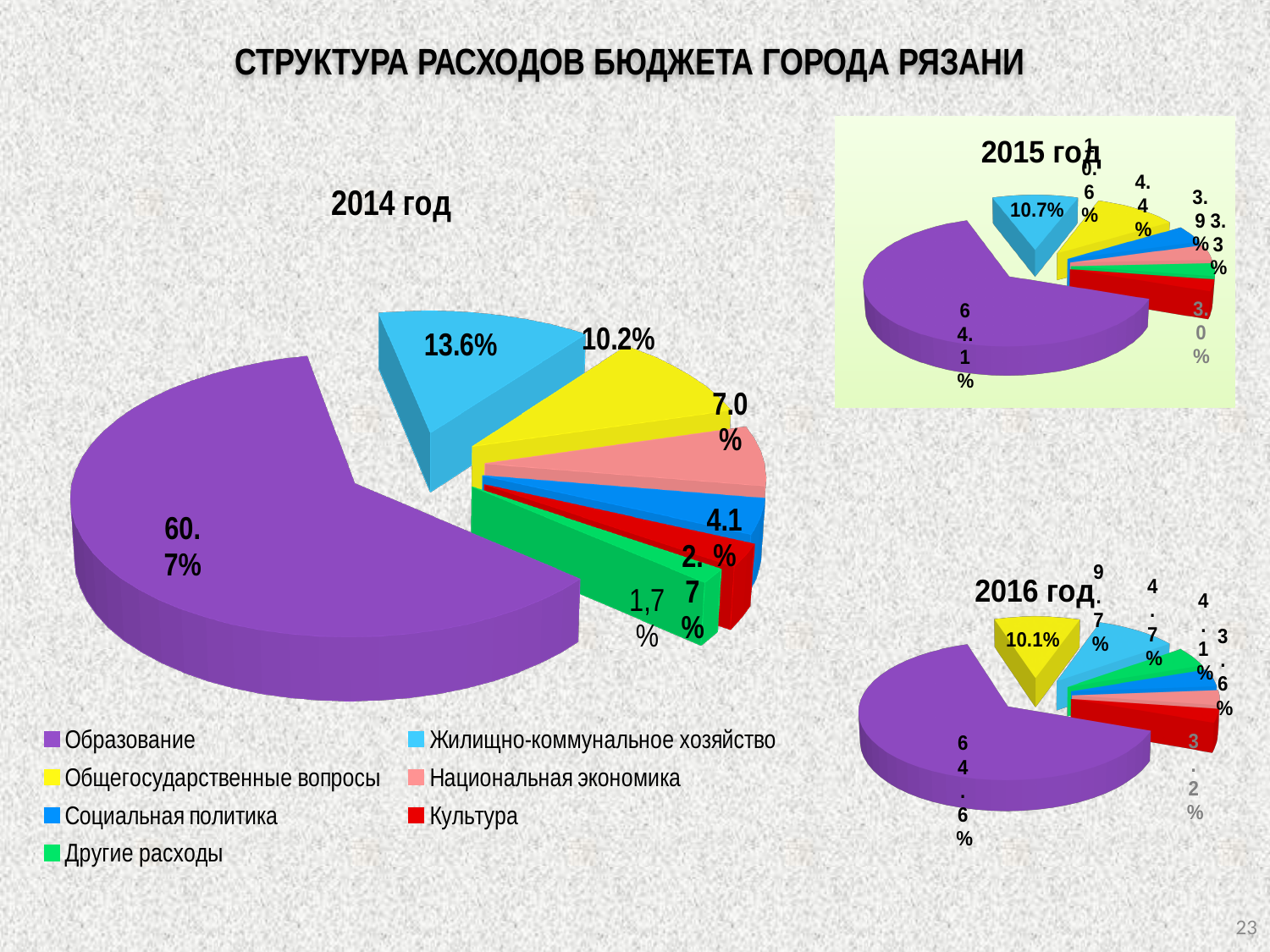
What kind of chart is used to show the 2014 год budget structure? Pie chart In the 2014 год pie chart, which category has the smallest share? Другие расходы In the 2014 год pie chart, what share is shown for Образование? 60.7% In the 2014 год pie chart, what share is shown for Жилищно-коммунальное хозяйство? 13.6% In the 2015 год pie chart, what share is shown for Образование? 64.1% In the 2014 год pie chart, what share is shown for Социальная политика? 4.1% In the 2014 год pie chart, what share is shown for Культура? 2.7% In the 2014 год pie chart, what share is shown for Общегосударственные вопросы? 10.2% How many categories does the legend list? 7 In the 2014 год pie chart, which category has the largest share? Образование In the 2014 год pie chart, what share is shown for Национальная экономика? 7.0% In the 2016 год pie chart, what share is shown for Образование? 64.6%